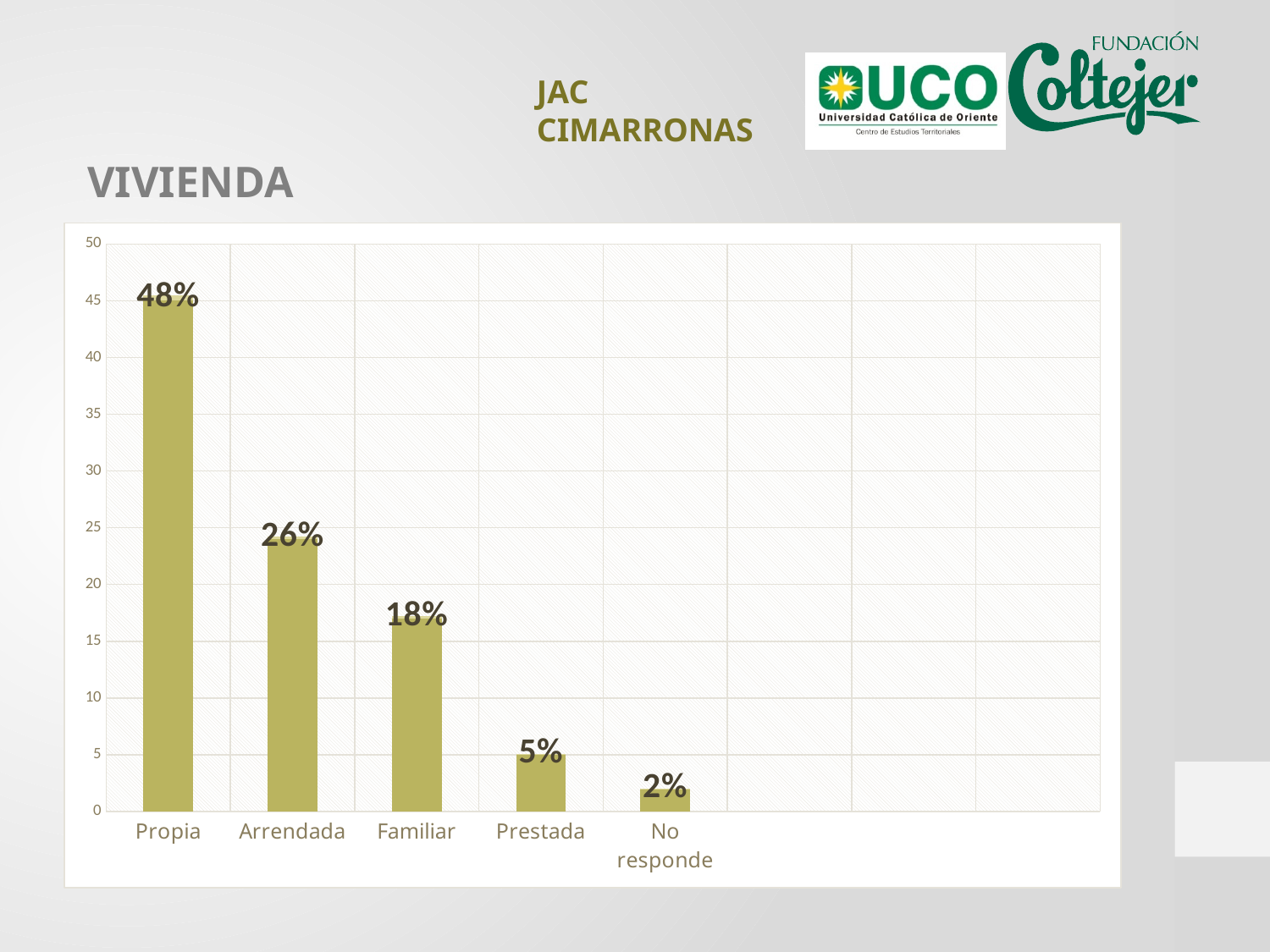
Which category has the lowest value? No responde What is the difference between the values for Propia and Arrendada? 22% What is the value for Propia? 48% What kind of chart is shown on the slide? Bar chart What is the difference between the values for Familiar and Prestada? 13% What is the value for No responde? 2% Which category has the highest value? Propia Do the values rise or fall from left to right along the x axis? Fall Which is larger, the value for Arrendada or the value for Familiar? Arrendada What is the value for Familiar? 18% How many categories are shown on the x axis? 5 What is the value for Arrendada? 26%